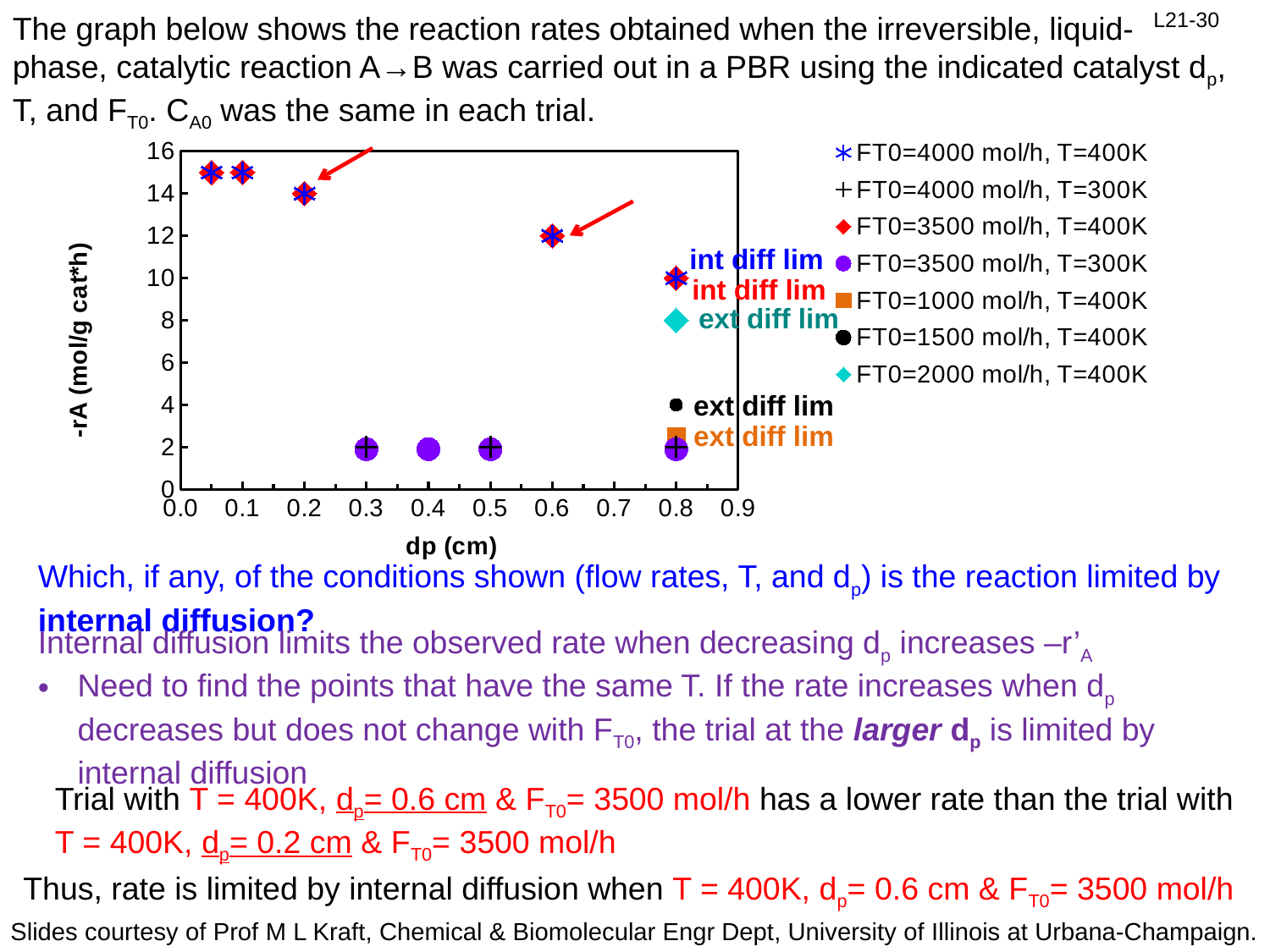
What kind of chart is shown on the slide? scatter chart Is the reaction rate at dp = 0.6 cm for T=400K greater or less than 14? less How many series does the chart legend list? 7 Is the reaction rate at dp = 0.8 cm for T=400K greater or less than 8? greater Is the reaction rate at dp = 0.3 cm for the T=300K trials greater or less than 4? less What is the title of the x axis of the chart? dp (cm) For the T=400K trials, does the reaction rate rise or fall as dp increases? fall What is the reaction rate at dp = 0.2 cm for FT0=3500 mol/h, T=400K? 14 What is the reaction rate at dp = 0.6 cm for FT0=3500 mol/h, T=400K? 12 What is the title of the y axis of the chart? -rA (mol/g cat*h) For FT0=3500 mol/h and T=400K, which has the larger reaction rate: dp = 0.2 cm or dp = 0.6 cm? dp = 0.2 cm